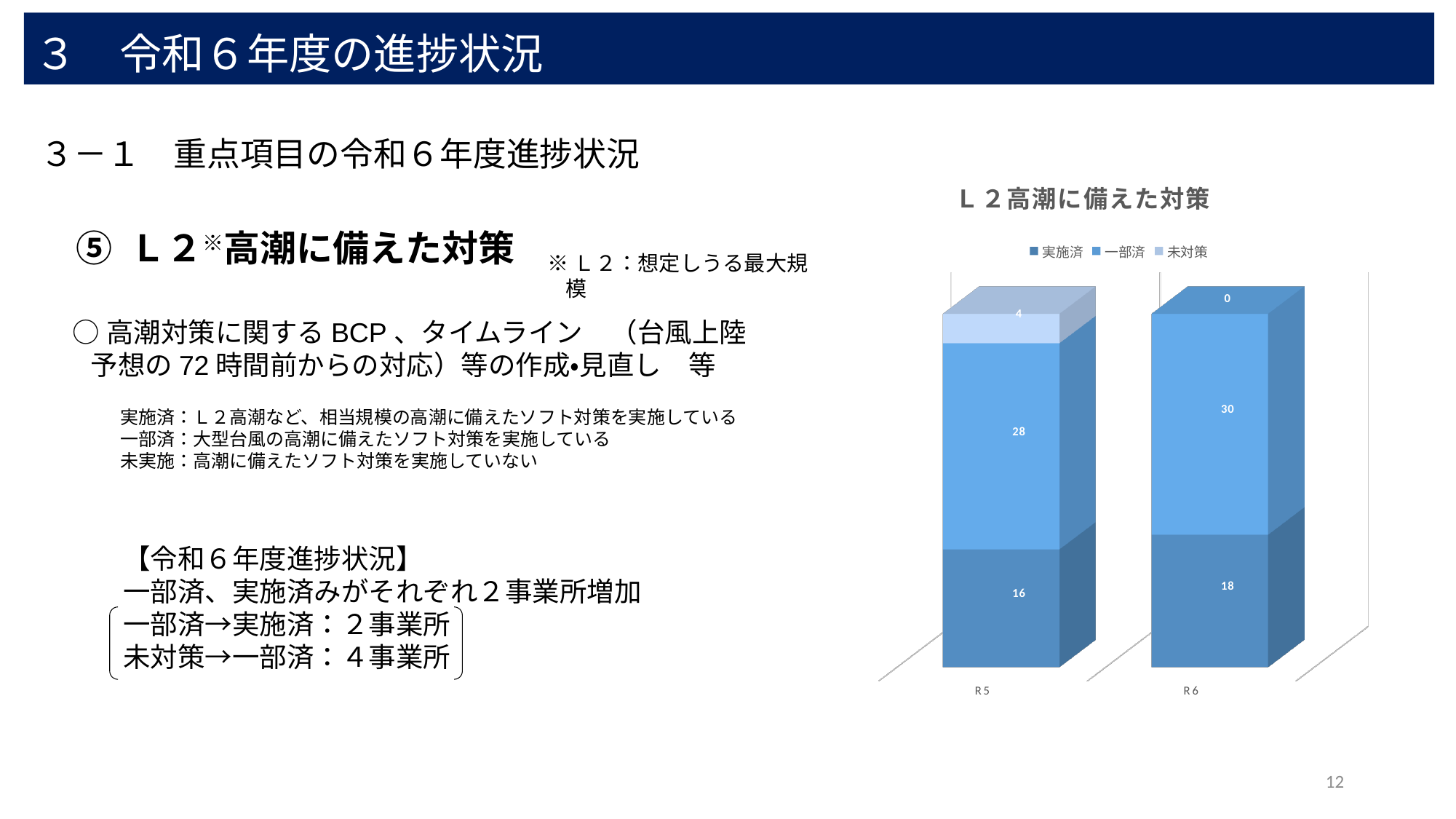
What is the difference between the 実施済 values for R6 and R5? 2 What is the value of 実施済 for R5? 16 What is the total of the stacked bar for R6? 48 What is the value of 一部済 for R6? 30 How many categories are shown on the x axis? 2 What is the total of the stacked bar for R5? 48 What kind of chart is shown? Stacked bar chart Which is larger, the 一部済 value for R5 or for R6? R6 What is the value of 未対策 for R6? 0 What is the value of 未対策 for R5? 4 What is the title of the chart? Ｌ２高潮に備えた対策 How many series does the legend list? 3